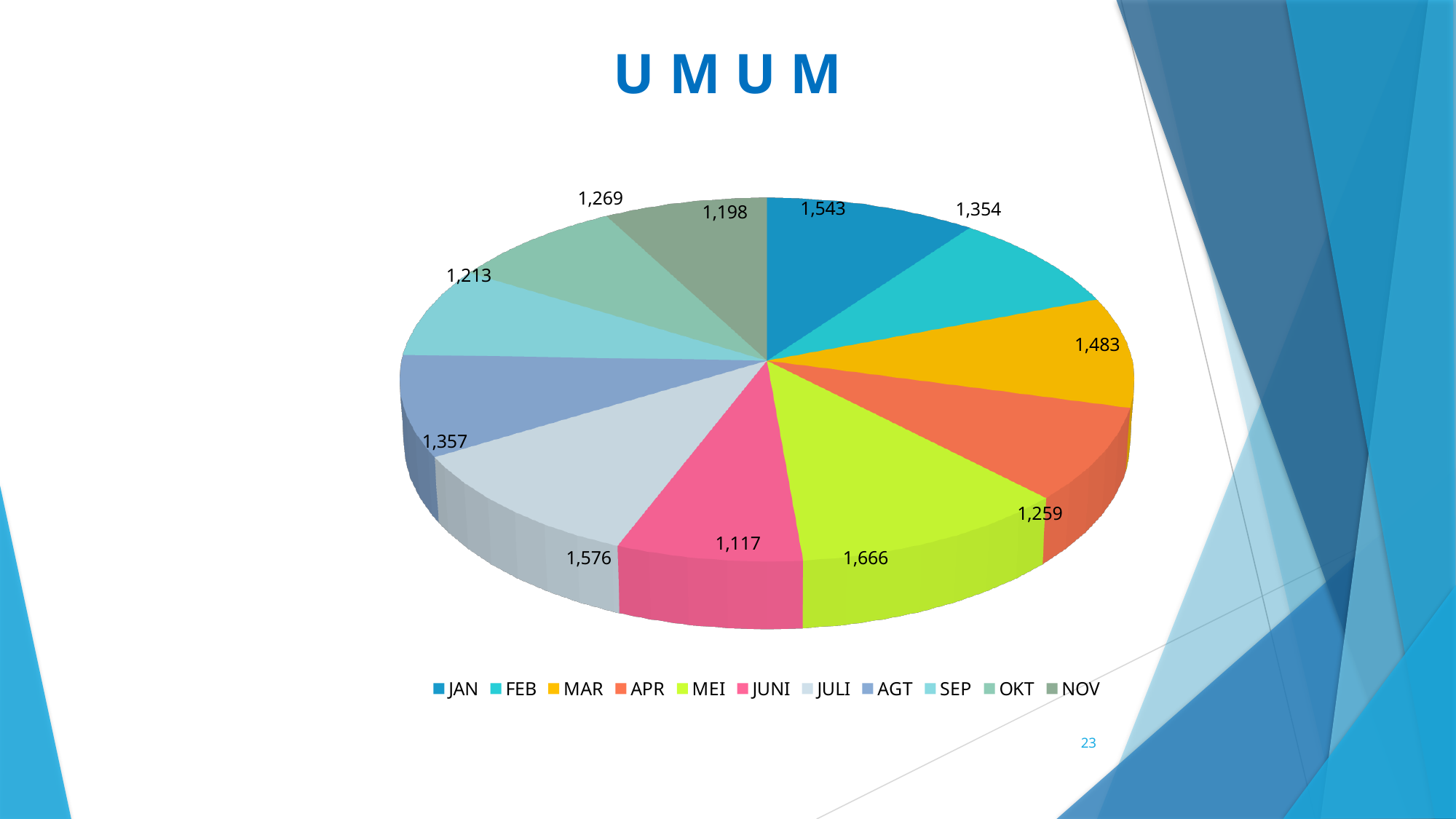
What is the value for JULI? 1,576 Which is larger, the value for APR or the value for OKT? OKT What type of chart is shown on the slide? Pie chart What is the difference between the values for MEI and JUNI? 549 Which month has the smallest slice? JUNI What is the title of the slide containing the chart? UMUM What is the difference between the values for MAR and FEB? 129 How many months (slices) are shown in the pie chart? 11 What is the value for MEI? 1,666 Which month has the largest slice? MEI What is the value for JAN? 1,543 What is the value for SEP? 1,213